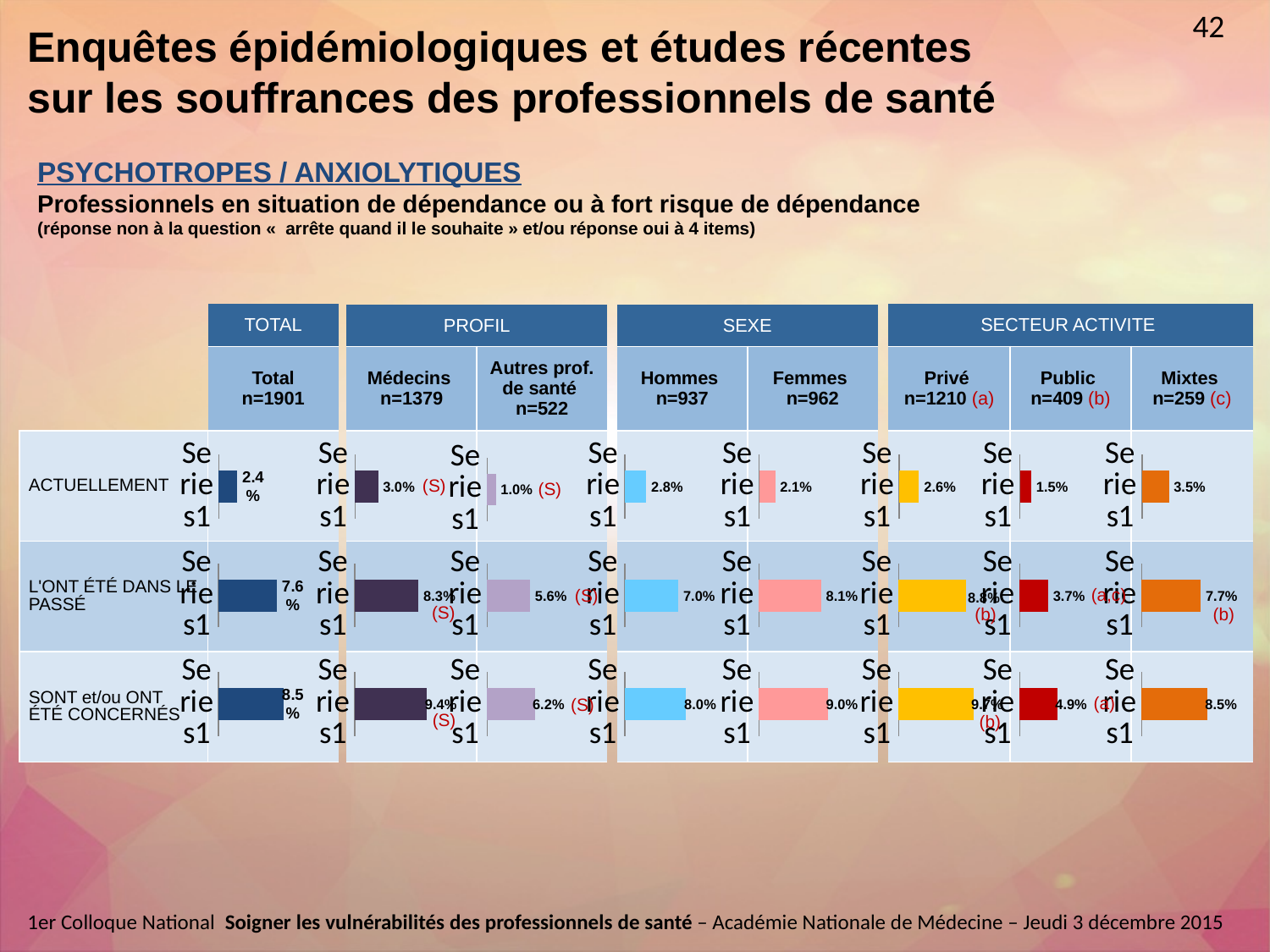
In the L'ONT ÉTÉ DANS LE PASSÉ row, what is the difference between the Privé value and the Public value? 5.1% In the ACTUELLEMENT row, what value is shown for Médecins? 3.0% In the SONT et/ou ONT ÉTÉ CONCERNÉS row, what value is shown for Privé? 9.7% In the SONT et/ou ONT ÉTÉ CONCERNÉS row, which is larger, the Hommes value or the Femmes value? Femmes In the L'ONT ÉTÉ DANS LE PASSÉ row, which column has the lowest value? Public In the L'ONT ÉTÉ DANS LE PASSÉ row, what value is shown for Femmes? 8.1% In the ACTUELLEMENT row, which column has the highest value? Mixtes What kind of chart is used in each cell of the table? bar chart In the SONT et/ou ONT ÉTÉ CONCERNÉS row, what value is shown for Public? 4.9% In the ACTUELLEMENT row, what value is shown for Total n=1901? 2.4% In the ACTUELLEMENT row, what is the difference between the Médecins value and the Autres prof. de santé value? 2.0% What colour are the bars in the Public column? dark red